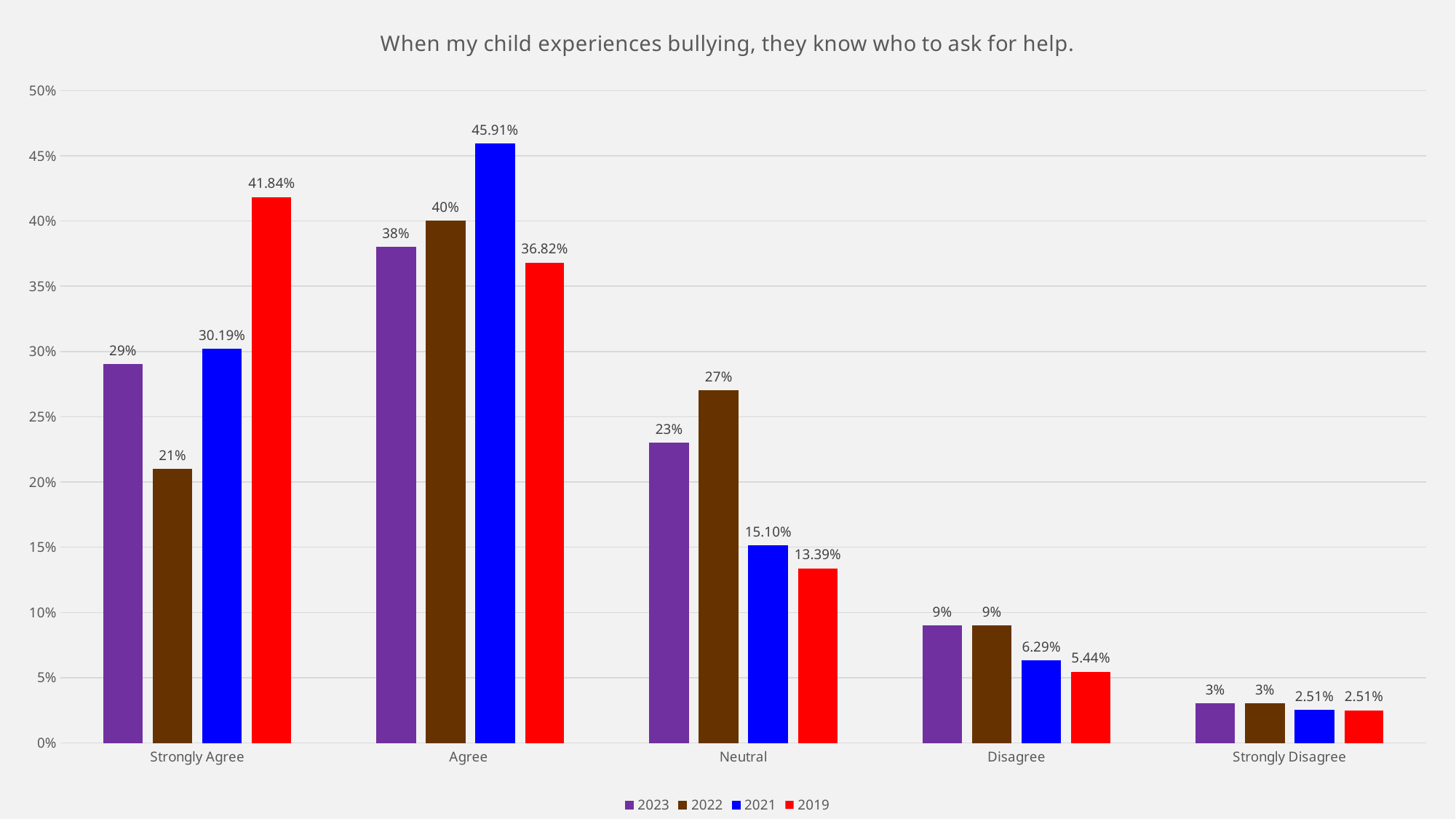
What is the difference between the 2022 and 2023 values for Strongly Agree? 8% How many series does the legend list? 4 What is the title of the chart? When my child experiences bullying, they know who to ask for help. Which category has the lowest 2019 value? Strongly Disagree Which category has the highest 2021 value? Agree What is the 2019 value for Strongly Agree? 41.84% How many categories are shown on the x axis? 5 Which is larger for Neutral: the 2021 value or the 2019 value? 2021 What is the 2023 value for Disagree? 9% What kind of chart is shown on the slide? Bar chart What is the 2021 value for Agree? 45.91% What is the 2022 value for Neutral? 27%